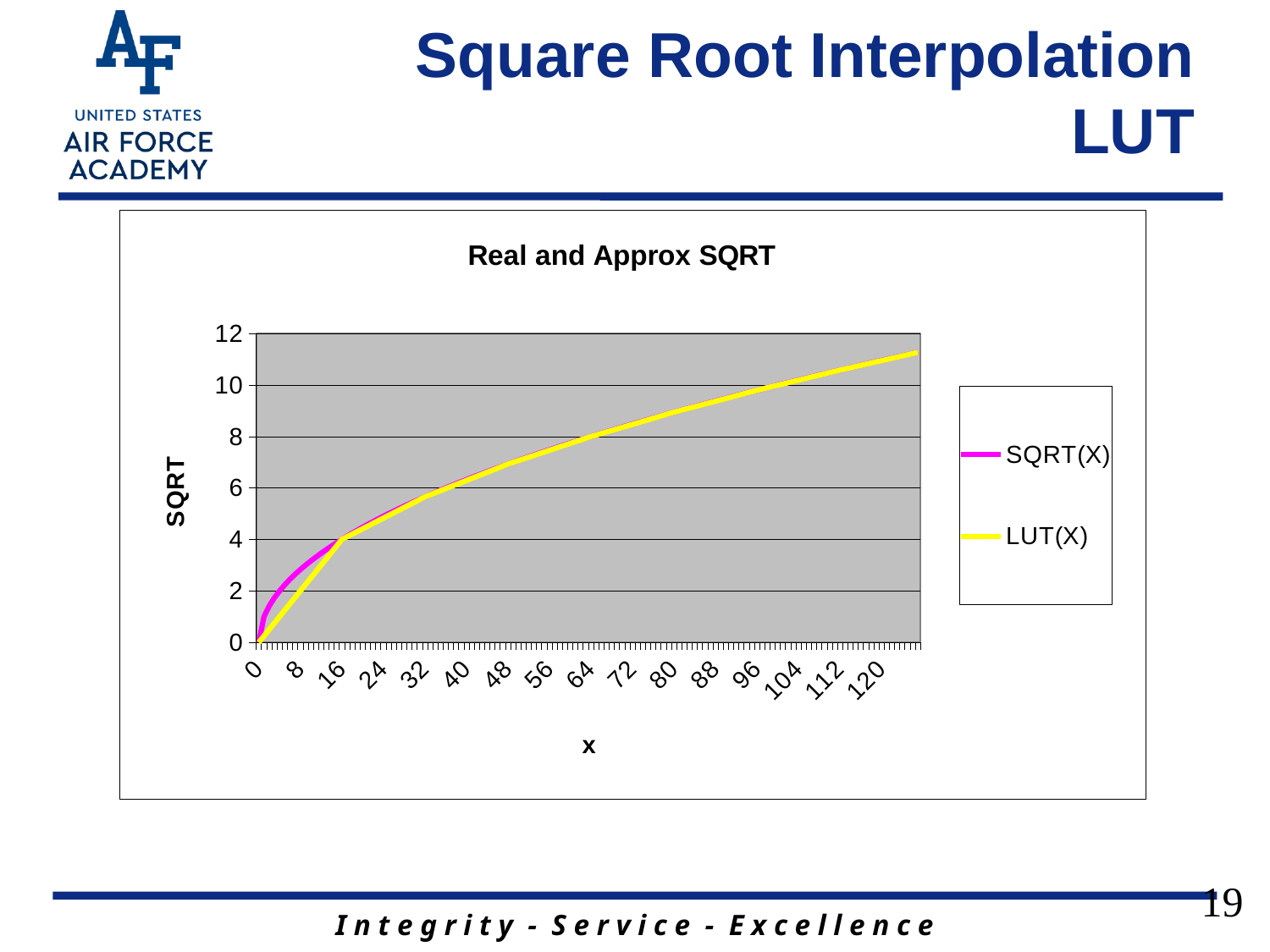
What is the title of the chart? Real and Approx SQRT Is the value of SQRT(X) at x = 8 greater or less than 2? greater Do the values of SQRT(X) rise or fall as x increases? rise Is the value of LUT(X) at x = 48 greater or less than 6? greater Which series is drawn in yellow? LUT(X) Is the value of SQRT(X) at x = 32 greater or less than 6? less How many series does the legend list? 2 At x = 8, which series has the higher value, SQRT(X) or LUT(X)? SQRT(X) What is the label of the vertical axis? SQRT What kind of chart is shown on the slide? line chart